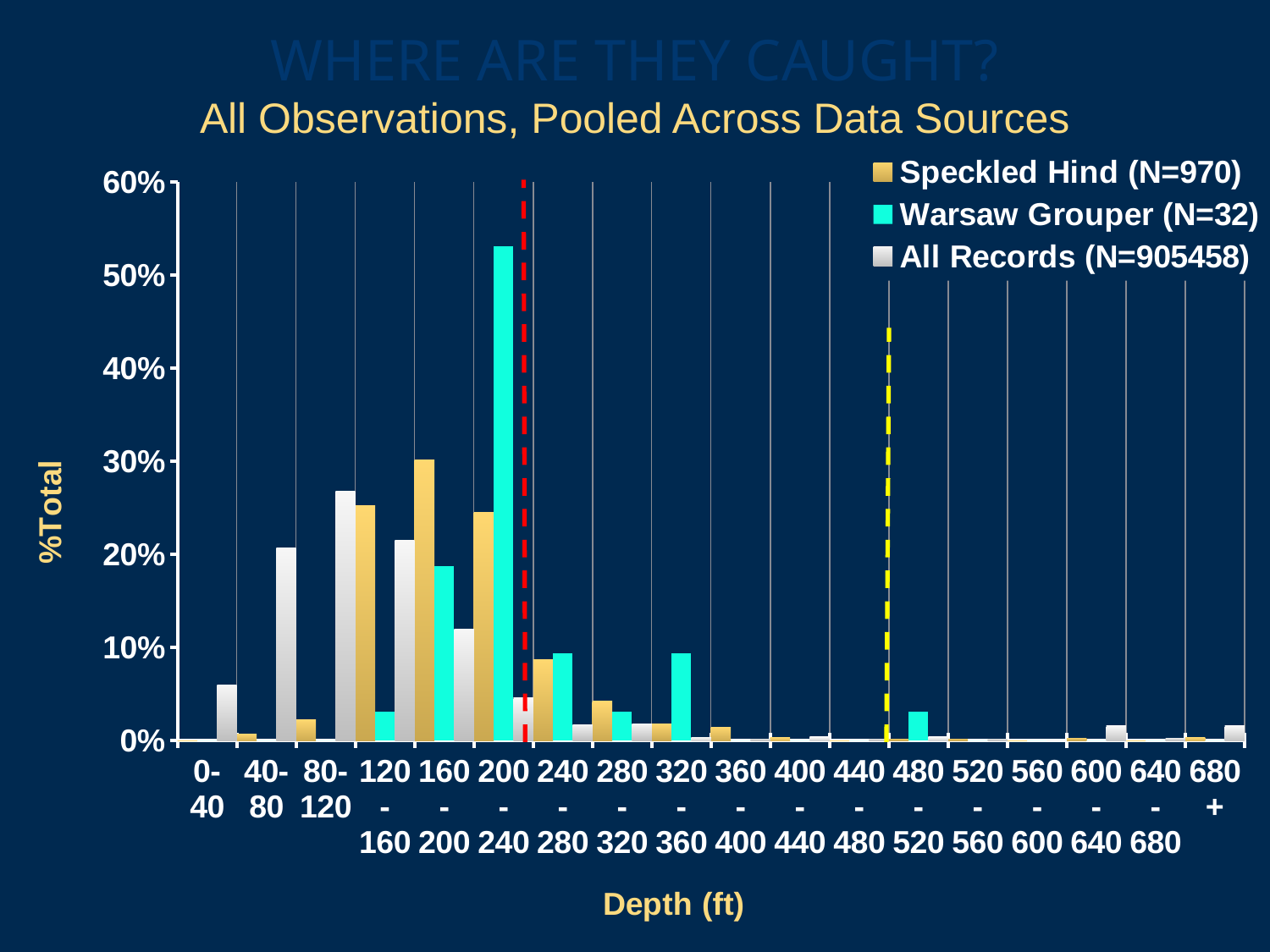
Is the Speckled Hind value for the 160-200 ft depth category greater or less than 20%? greater How many series does the legend list? 3 What kind of chart is shown on the slide? bar chart Is the Speckled Hind value for the 240-280 ft depth category greater or less than 10%? less Is the Warsaw Grouper value for the 200-240 ft depth category greater or less than 50%? greater In the 120-160 ft depth category, which is larger: Speckled Hind or Warsaw Grouper? Speckled Hind How many depth categories are shown on the x axis? 18 In which depth category is the Warsaw Grouper value highest? 200-240 What sample size (N) does the legend give for Warsaw Grouper? N=32 In the 40-80 ft depth category, which is larger: All Records or Speckled Hind? All Records In which depth category is the Speckled Hind value highest? 160-200 In which depth category is the All Records value highest? 80-120